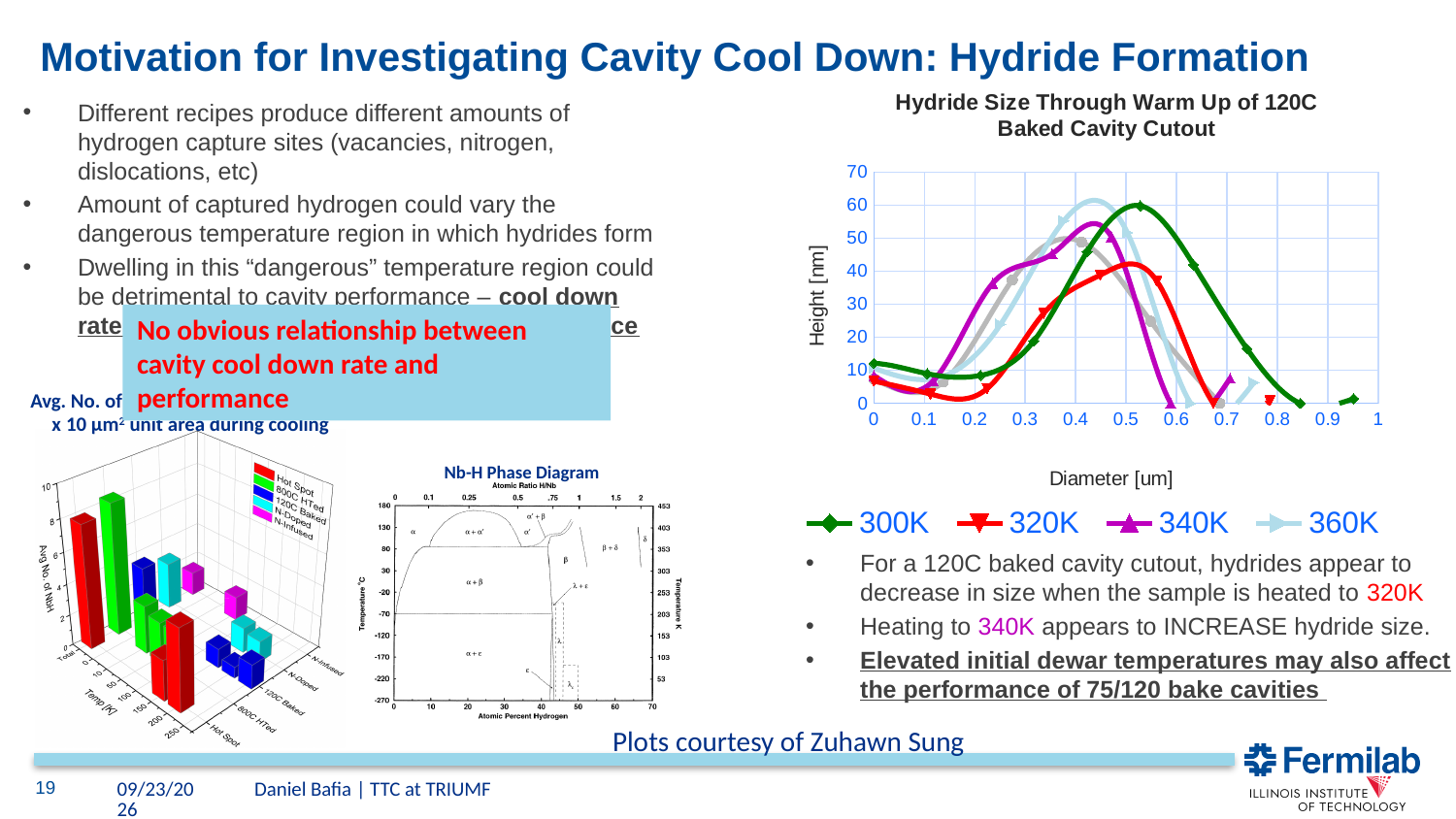
In the chart titled "Hydride Size Through Warm Up of 120C Baked Cavity Cutout", what is the label of the horizontal axis? Diameter [um] In the chart titled "Hydride Size Through Warm Up of 120C Baked Cavity Cutout", which series has the lowest peak height? 320K In the chart titled "Hydride Size Through Warm Up of 120C Baked Cavity Cutout", how many series does the legend list? 4 In the 3D chart at the bottom left of the slide, what kind of chart is shown? Bar chart In the chart titled "Hydride Size Through Warm Up of 120C Baked Cavity Cutout", what kind of chart is shown? Line chart In the chart titled "Hydride Size Through Warm Up of 120C Baked Cavity Cutout", is the peak height of the 300K series greater or less than 50? greater In the chart titled "Hydride Size Through Warm Up of 120C Baked Cavity Cutout", which series has a higher peak, 300K or 320K? 300K In the chart titled "Hydride Size Through Warm Up of 120C Baked Cavity Cutout", is the peak height of the 320K series greater or less than 50? less In the 3D chart at the bottom left of the slide, how many series does the legend list? 5 In the chart titled "Hydride Size Through Warm Up of 120C Baked Cavity Cutout", is the peak height of the 340K series greater or less than 40? greater In the chart titled "Hydride Size Through Warm Up of 120C Baked Cavity Cutout", what is the label of the vertical axis? Height [nm]